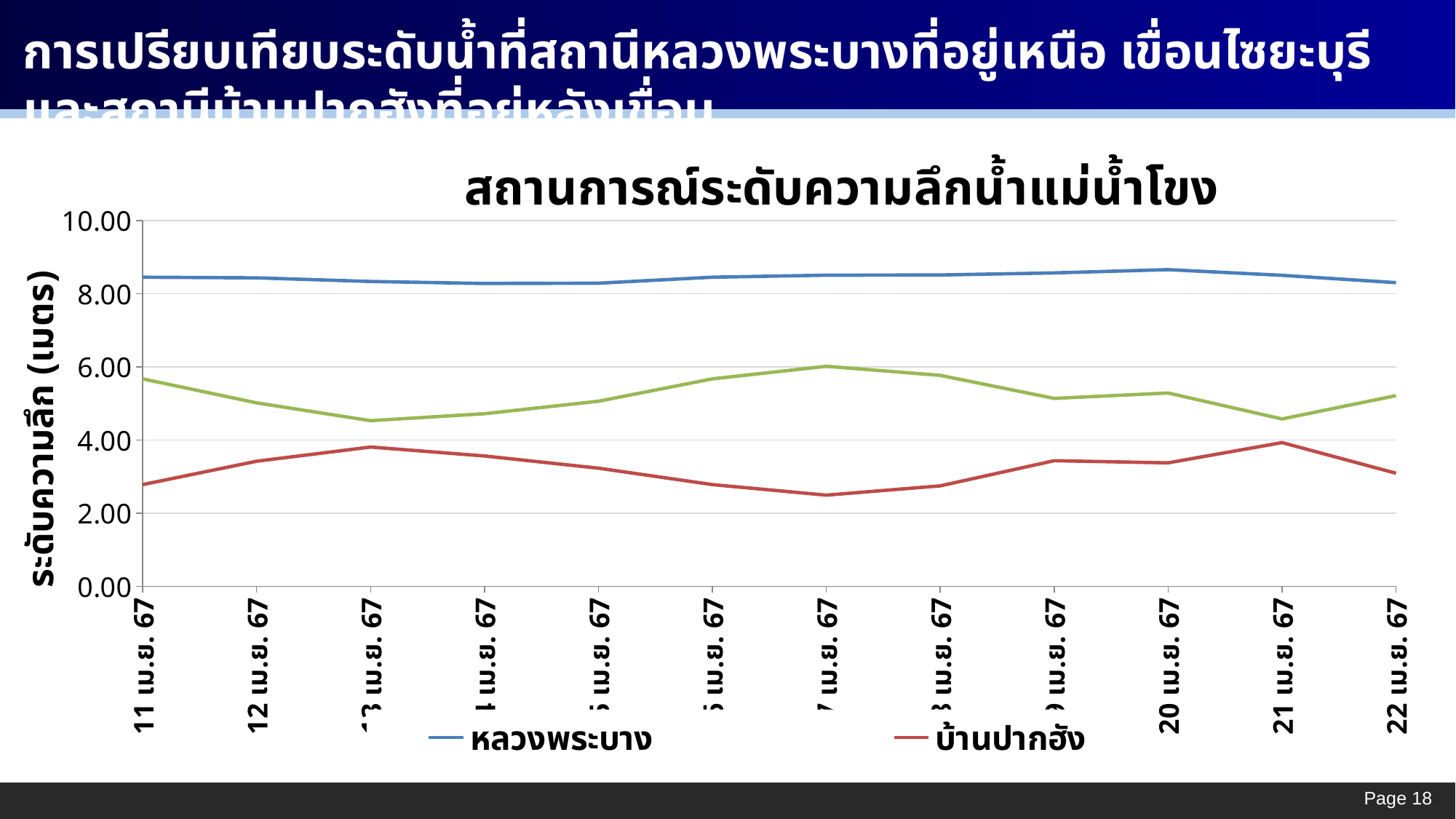
On 22 เม.ย. 67, which series has the higher value, หลวงพระบาง or บ้านปากฮัง? หลวงพระบาง What is the title of the chart? สถานการณ์ระดับความลึกน้ำแม่น้ำโขง For บ้านปากฮัง, which date has the larger value, 11 เม.ย. 67 or 21 เม.ย. 67? 21 เม.ย. 67 Is the value for หลวงพระบาง on 20 เม.ย. 67 greater or less than 8.00? greater How many dates are shown along the x axis of the chart? 12 Is the value for หลวงพระบาง on 11 เม.ย. 67 greater or less than 8.00? greater Does the หลวงพระบาง line rise or fall from 20 เม.ย. 67 to 22 เม.ย. 67? fall Is the value for บ้านปากฮัง on 21 เม.ย. 67 greater or less than 2.00? greater What kind of chart is shown on the slide? line chart How many series does the chart legend list? 2